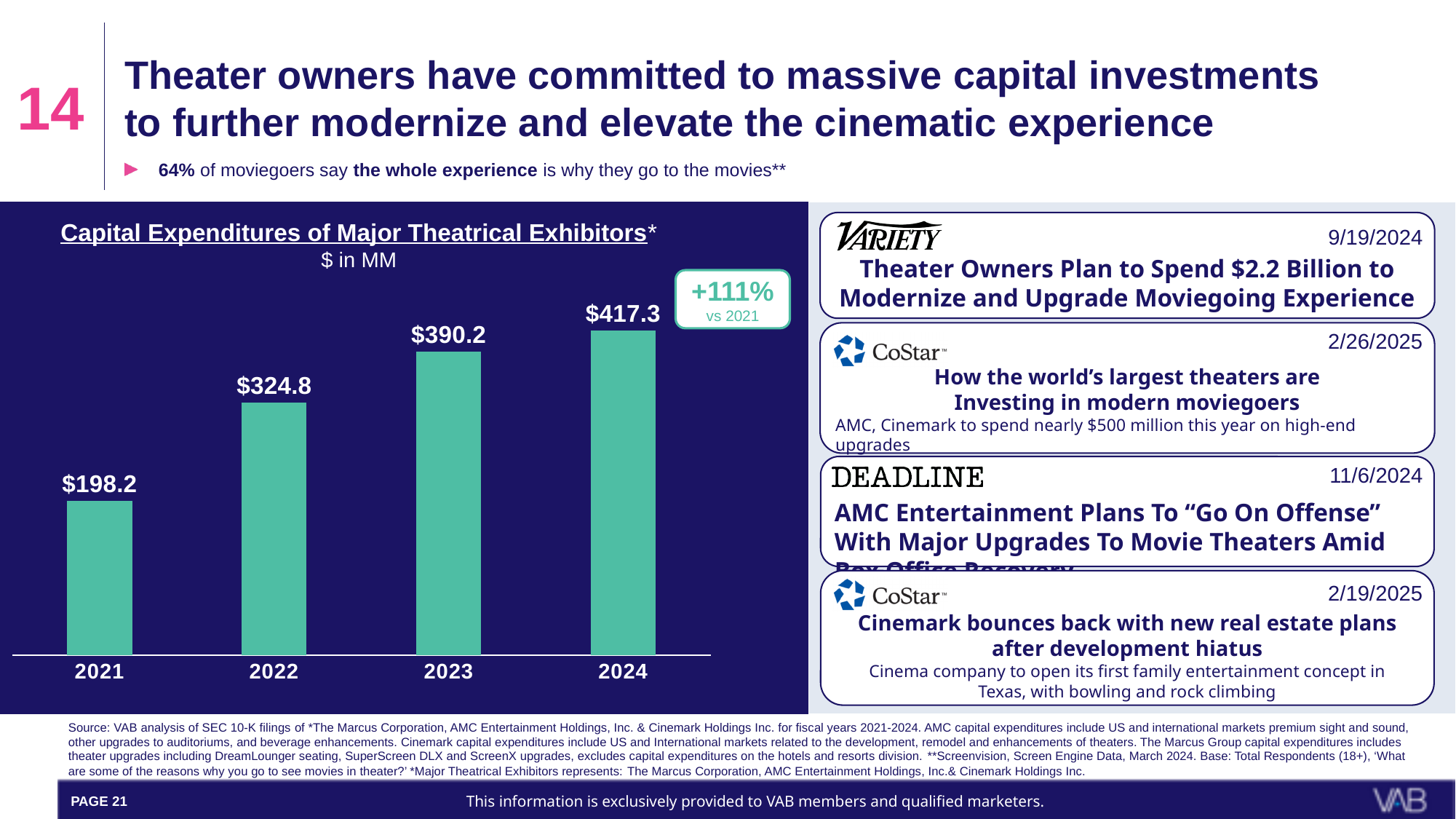
What kind of chart is used to show capital expenditures? Bar chart What is the capital expenditure value shown for 2023? $390.2 Do capital expenditures rise or fall from 2021 to 2024? Rise Which year has the lowest capital expenditure? 2021 What is the difference between the 2024 and 2021 capital expenditure values? $219.1 What percentage change vs 2021 is called out on the chart? +111% Which year has a larger capital expenditure, 2022 or 2023? 2023 What is the capital expenditure value shown for 2024? $417.3 What is the capital expenditure value shown for 2021? $198.2 How many years are shown on the chart? 4 What is the difference between the 2023 and 2022 capital expenditure values? $65.4 Which year has the highest capital expenditure? 2024